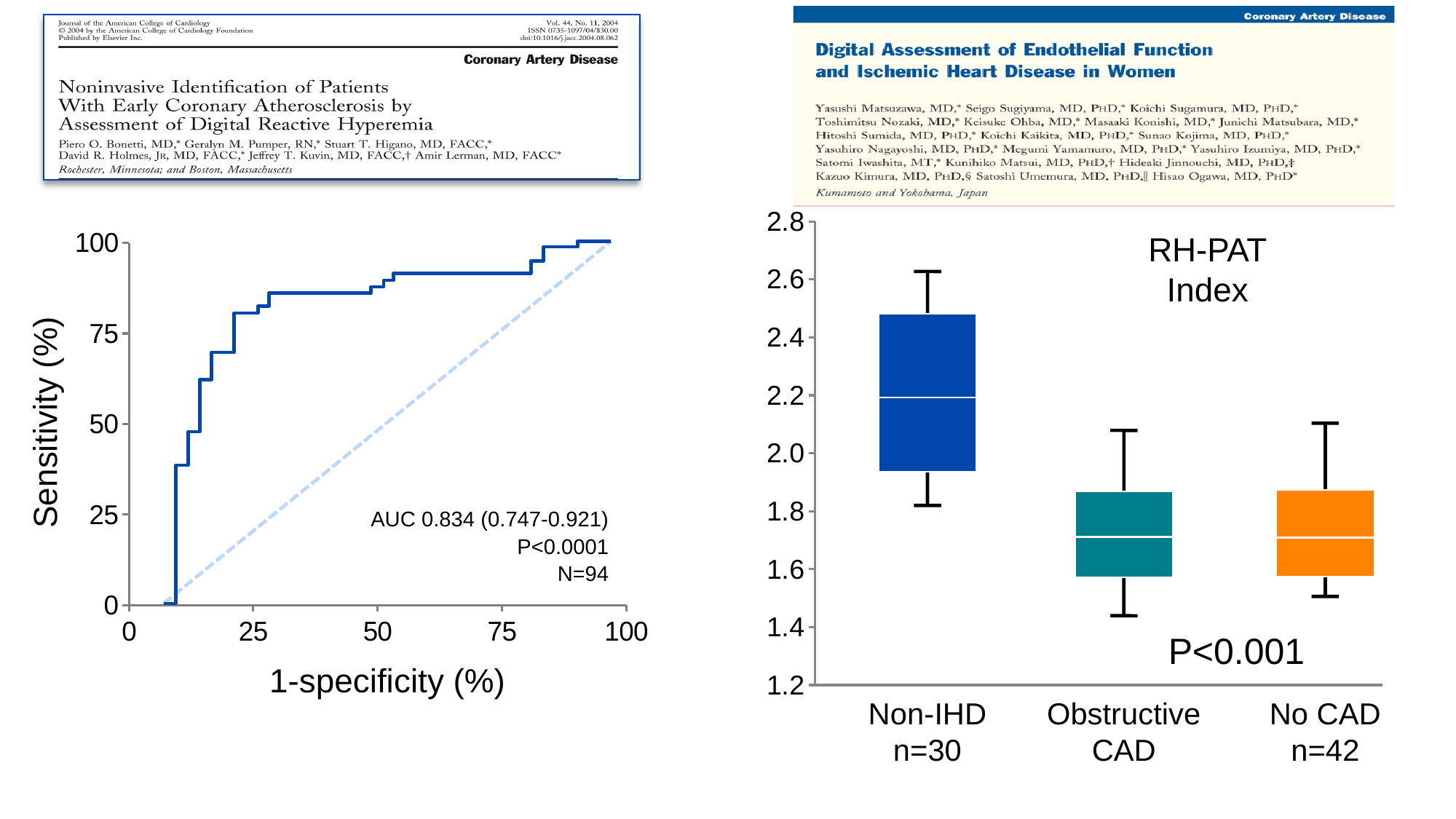
On the right RH-PAT Index chart, is the median for Non-IHD greater or less than 2.0? greater On the left ROC chart, what P value is printed? P<0.0001 On the left ROC chart, what is the label of the x axis? 1-specificity (%) On the left ROC chart, what is the sample size N? 94 On the left ROC chart, what is the confidence interval printed next to the AUC? 0.747-0.921 On the left ROC chart, what AUC value is printed? 0.834 What kind of chart is the left chart with Sensitivity (%) on the y axis? line chart On the right RH-PAT Index chart, what is the sample size n for the No CAD group? 42 On the right RH-PAT Index chart, which group has the highest median? Non-IHD What kind of chart is the right chart showing the RH-PAT Index? box plot On the right RH-PAT Index chart, is the median for Obstructive CAD greater or less than 1.8? less On the right RH-PAT Index chart, how many groups are plotted? 3